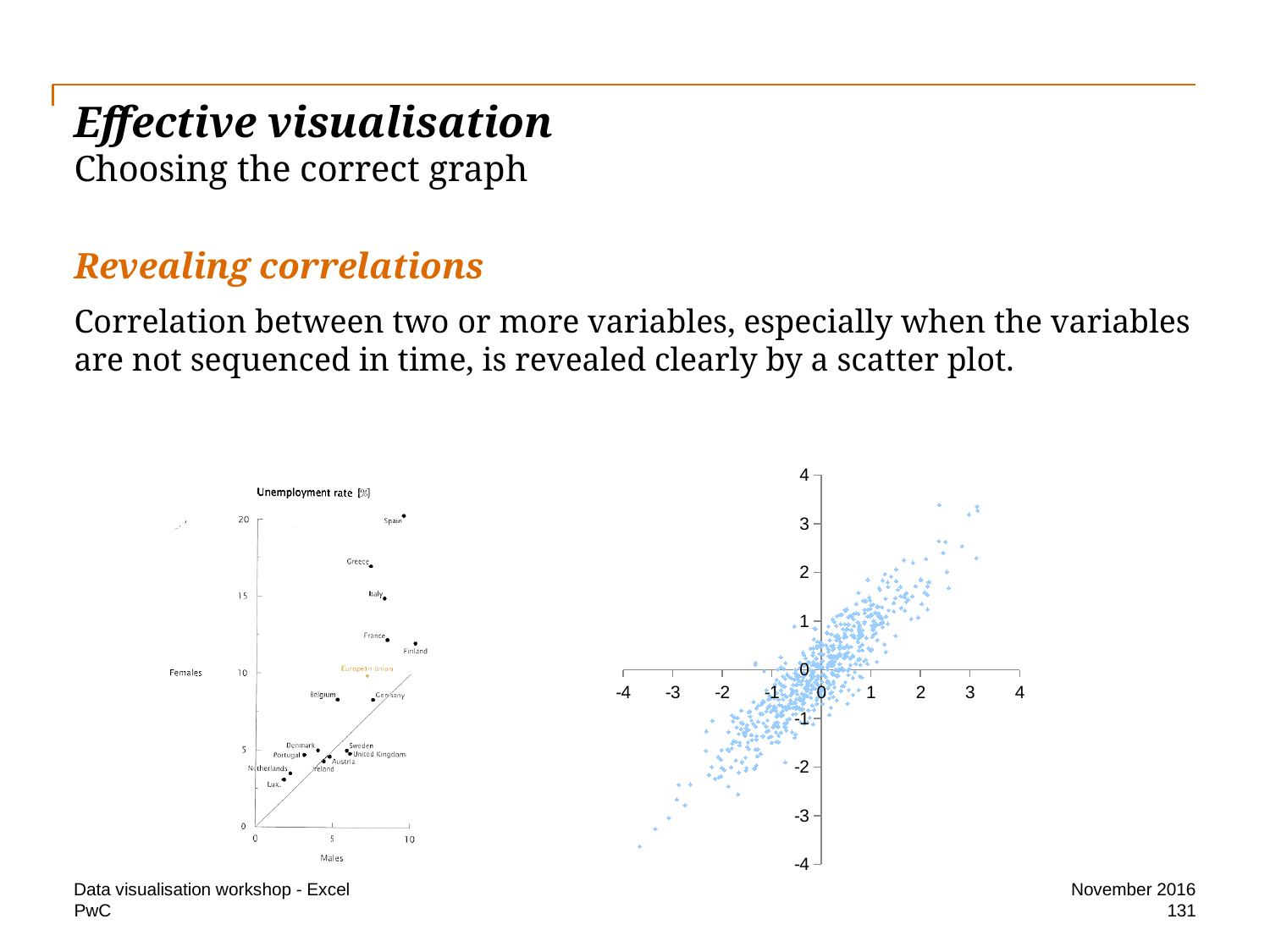
What kind of chart is the chart on the left of the slide, titled 'Unemployment rate [%]'? scatter plot In the 'Unemployment rate [%]' chart, is the male unemployment rate for Germany greater or less than 5? greater In the 'Unemployment rate [%]' chart, which has the higher male unemployment rate, Belgium or Germany? Germany What kind of chart is the chart on the right of the slide? scatter plot In the chart on the right, do the plotted values generally rise or fall as the x value increases? rise In the chart on the right, what is the maximum value shown on the x axis? 4 In the 'Unemployment rate [%]' chart, which has the higher female unemployment rate, Greece or Italy? Greece In the 'Unemployment rate [%]' chart, which country has the highest female unemployment rate? Spain In the 'Unemployment rate [%]' chart, is the female unemployment rate for Netherlands greater or less than 5? less In the 'Unemployment rate [%]' chart, what is the label of the x axis? Males In the 'Unemployment rate [%]' chart, is the female unemployment rate for France greater or less than 15? less